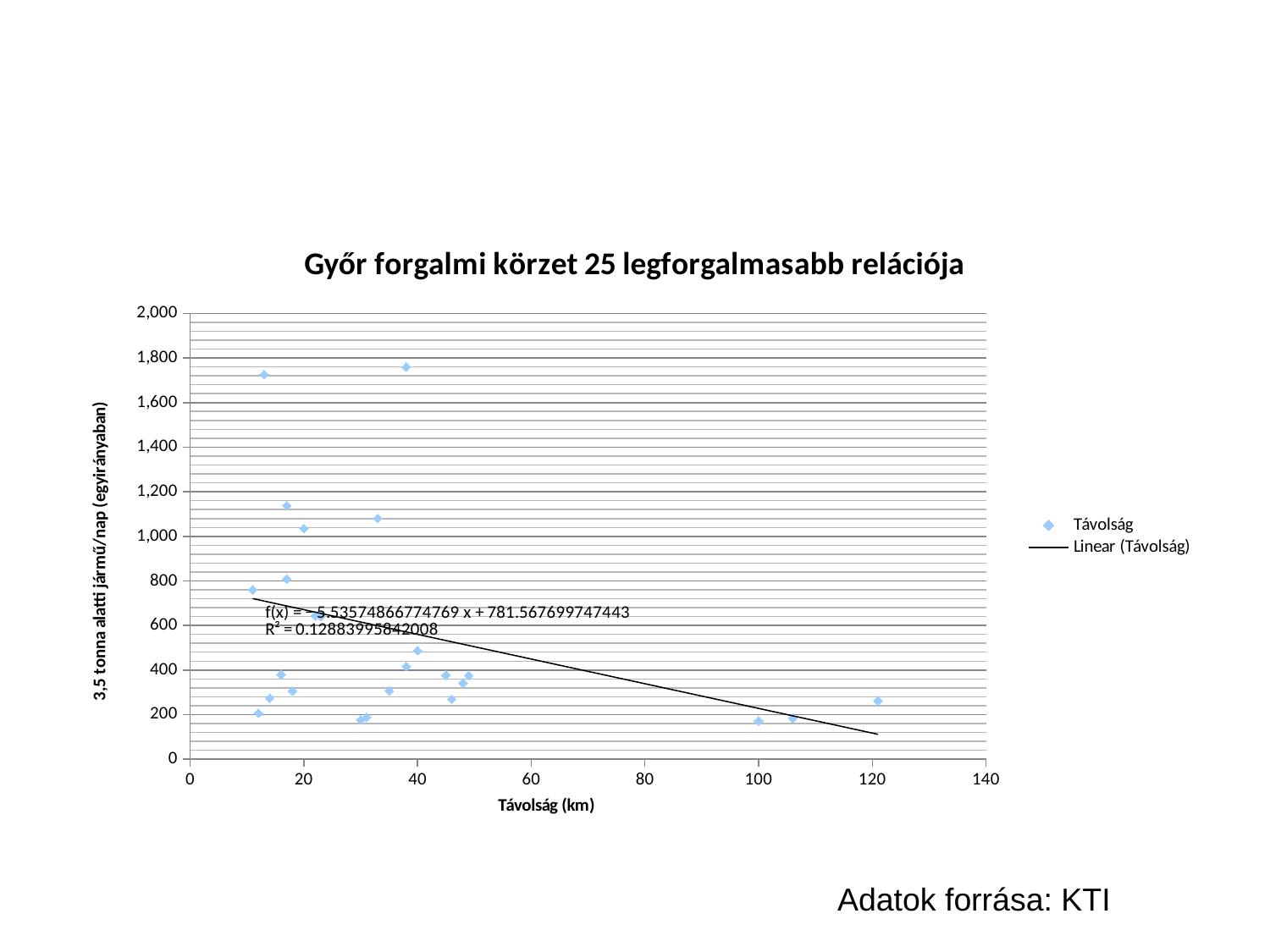
Is the value of the rightmost point (at about 120 km) greater or less than 600? less According to the fitted trendline, do the values rise or fall as Távolság (km) increases? fall Is the value of the highest point on the chart greater or less than 1,600? greater What R² value is printed on the chart for the linear trendline? 0.12883995842008 What is the title of the chart? Győr forgalmi körzet 25 legforgalmasabb relációja What kind of chart is shown on the slide? scatter chart How many entries does the chart legend list? 2 Is the value of the point plotted at about 33 km greater or less than 1,000? greater